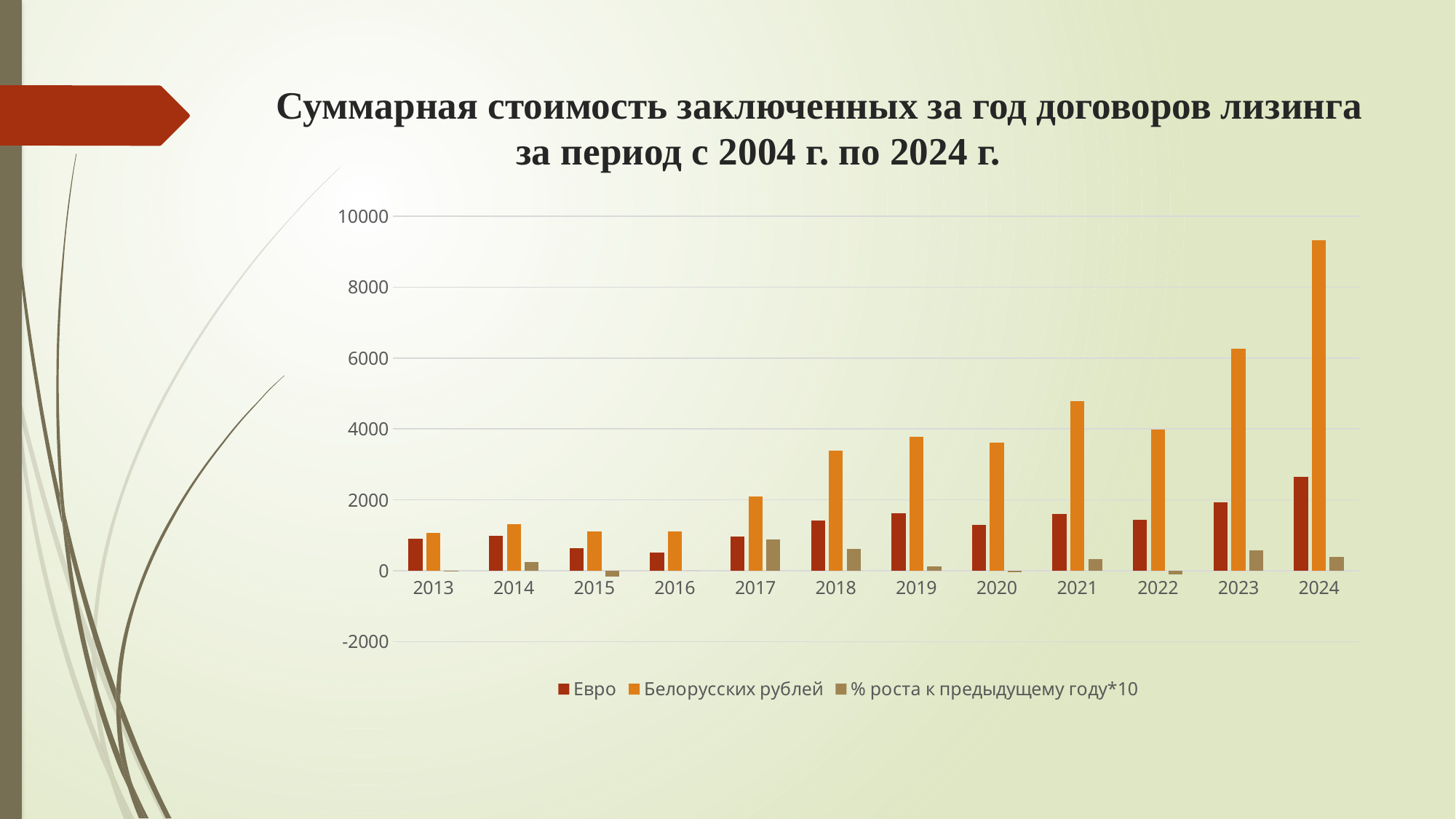
How many years are shown on the x axis? 12 Do the values for Белорусских рублей generally rise or fall from 2013 to 2024? rise Which year has the lowest value for Евро? 2016 Which year has the highest value for Евро? 2024 Which is larger for Белорусских рублей: the value in 2021 or in 2022? 2021 Is the value for Белорусских рублей in 2021 greater or less than 4000? greater What kind of chart is shown on the slide? bar chart Is the value for Евро in 2016 greater or less than 1000? less Which year has the highest value for Белорусских рублей? 2024 How many series does the legend list? 3 Is the value for Белорусских рублей in 2024 greater or less than 8000? greater Which series is shown in dark red? Евро